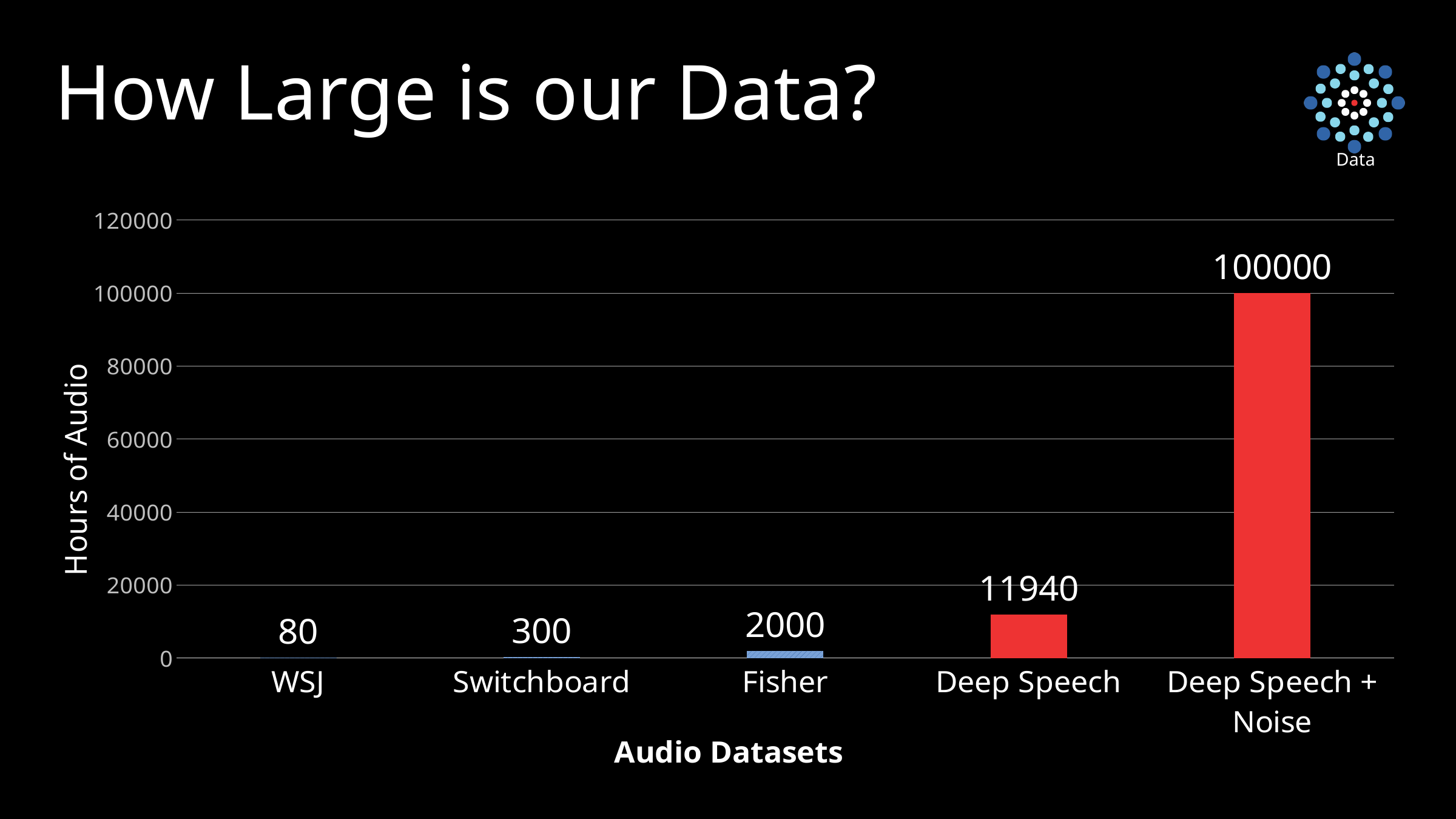
What is the difference between Fisher and Switchboard? 1700 What is the value for WSJ? 80 Which is larger, Deep Speech or Fisher? Deep Speech Which dataset has the lowest hours of audio? WSJ How many datasets are shown on the x axis? 5 What is the value for Fisher? 2000 What is the value for Deep Speech? 11940 What is the difference between Deep Speech + Noise and Deep Speech? 88060 What is the value for Switchboard? 300 What is the label of the y axis? Hours of Audio Which dataset has the highest hours of audio? Deep Speech + Noise What kind of chart is this? bar chart